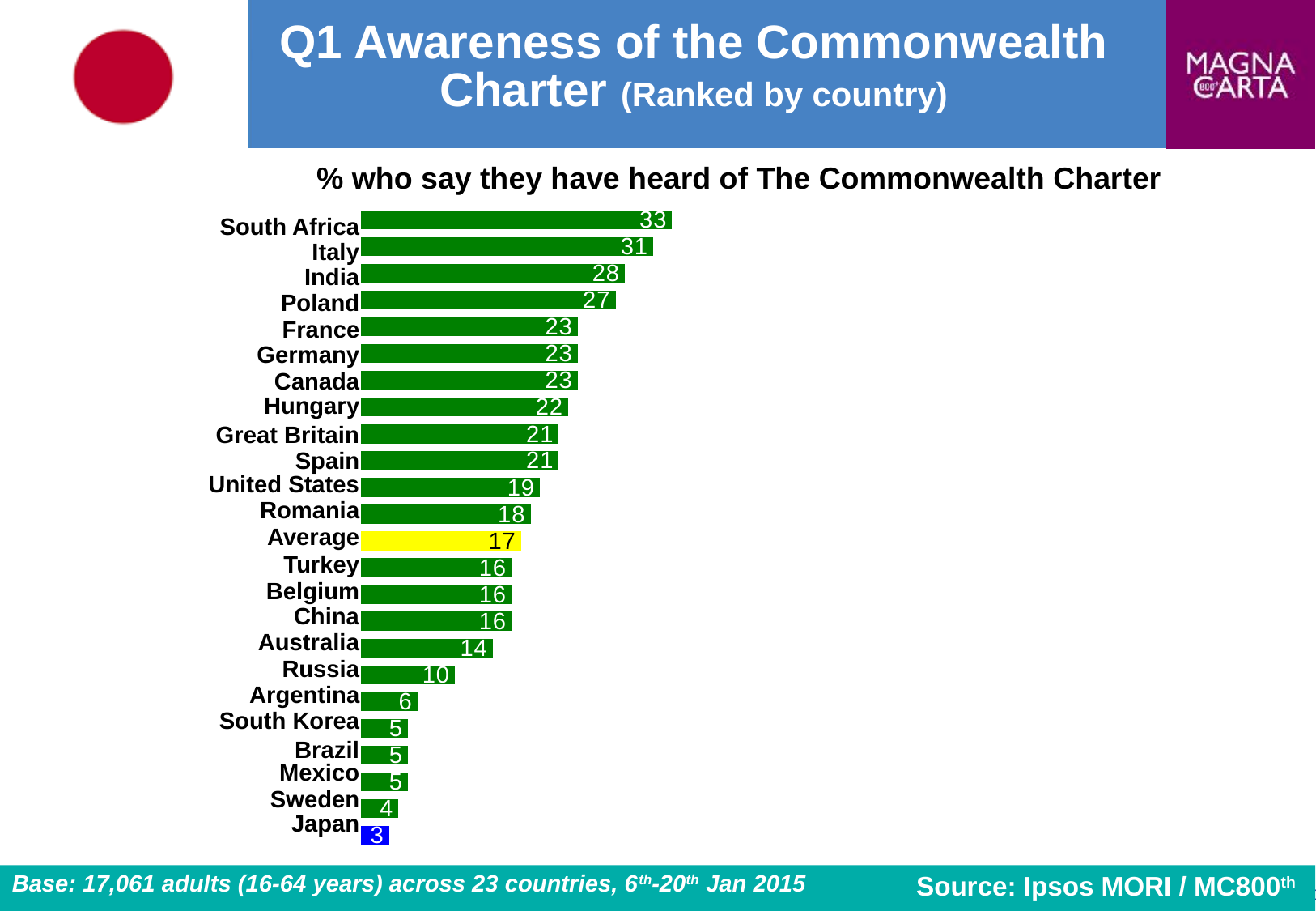
What type of chart is shown on the slide? Bar chart Which has a higher value, Poland or Hungary? Poland How many countries are shown in the chart (excluding the Average bar)? 23 What percentage of people in South Africa say they have heard of The Commonwealth Charter? 33 What colour is the Average bar? Yellow What is the difference between the values for Italy and India? 3 What is the value shown for the Average bar? 17 Which has a higher value, Australia or Argentina? Australia Which country has the highest awareness of The Commonwealth Charter? South Africa What is the difference between the values for Great Britain and Japan? 18 Which country has the lowest awareness of The Commonwealth Charter? Japan What value is shown for Russia? 10